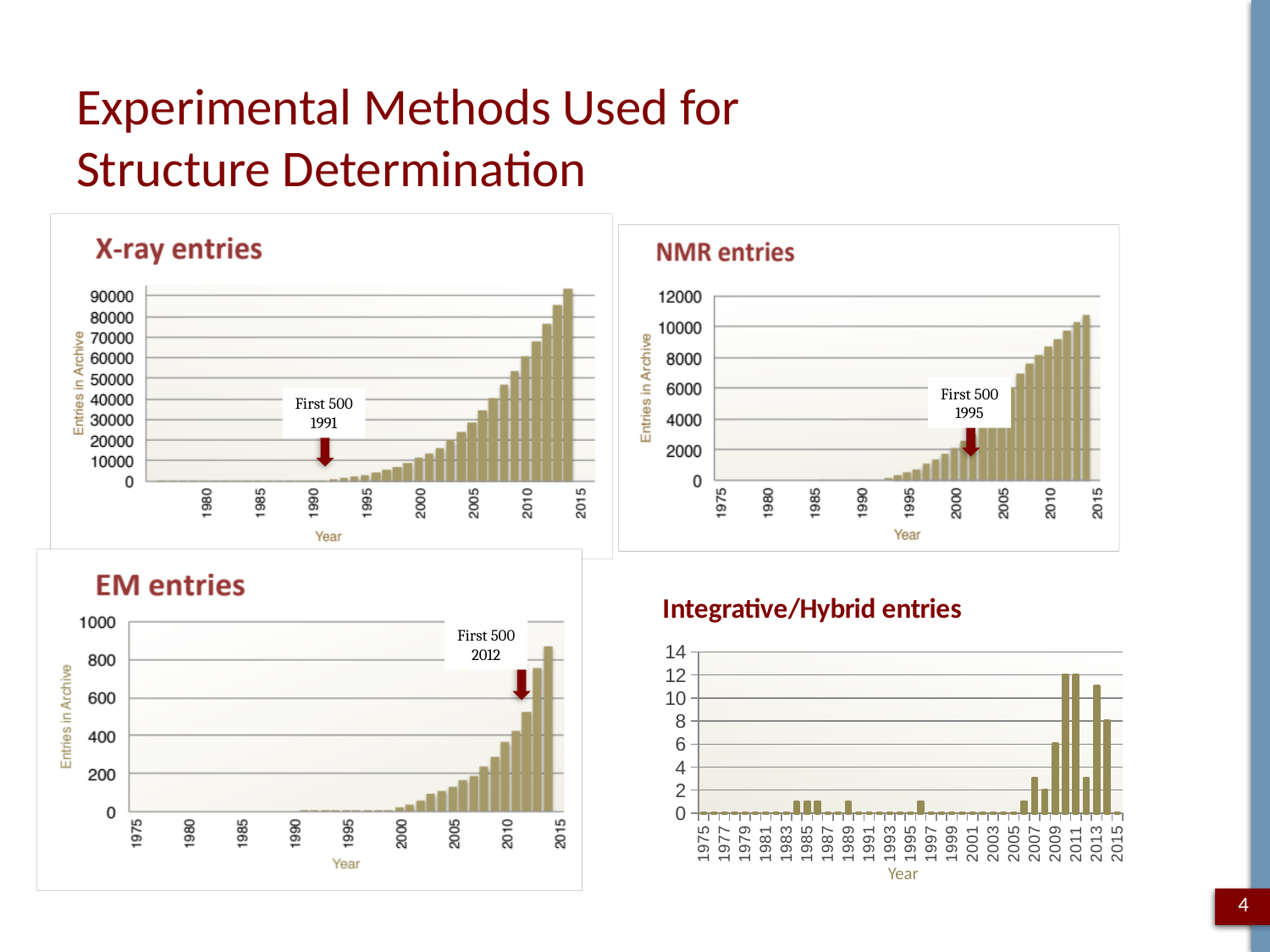
In the NMR entries chart, is the value for 2005 greater or less than 4000? greater What kind of chart is the X-ray entries chart? bar chart In the Integrative/Hybrid entries chart, what is the value for 2009? 6 According to the annotation on the NMR entries chart, in which year were the first 500 entries reached? 1995 In the Integrative/Hybrid entries chart, what is the value for 2014? 8 In the NMR entries chart, is the value for 2010 greater or less than 10000? less In the EM entries chart, is the value for 2005 greater or less than 200? less In the Integrative/Hybrid entries chart, what is the difference between the values for 2010 and 2014? 4 In the X-ray entries chart, which year has more entries, 2005 or 2010? 2010 In the X-ray entries chart, do the entries rise or fall over the years? rise According to the annotation on the EM entries chart, in which year were the first 500 entries reached? 2012